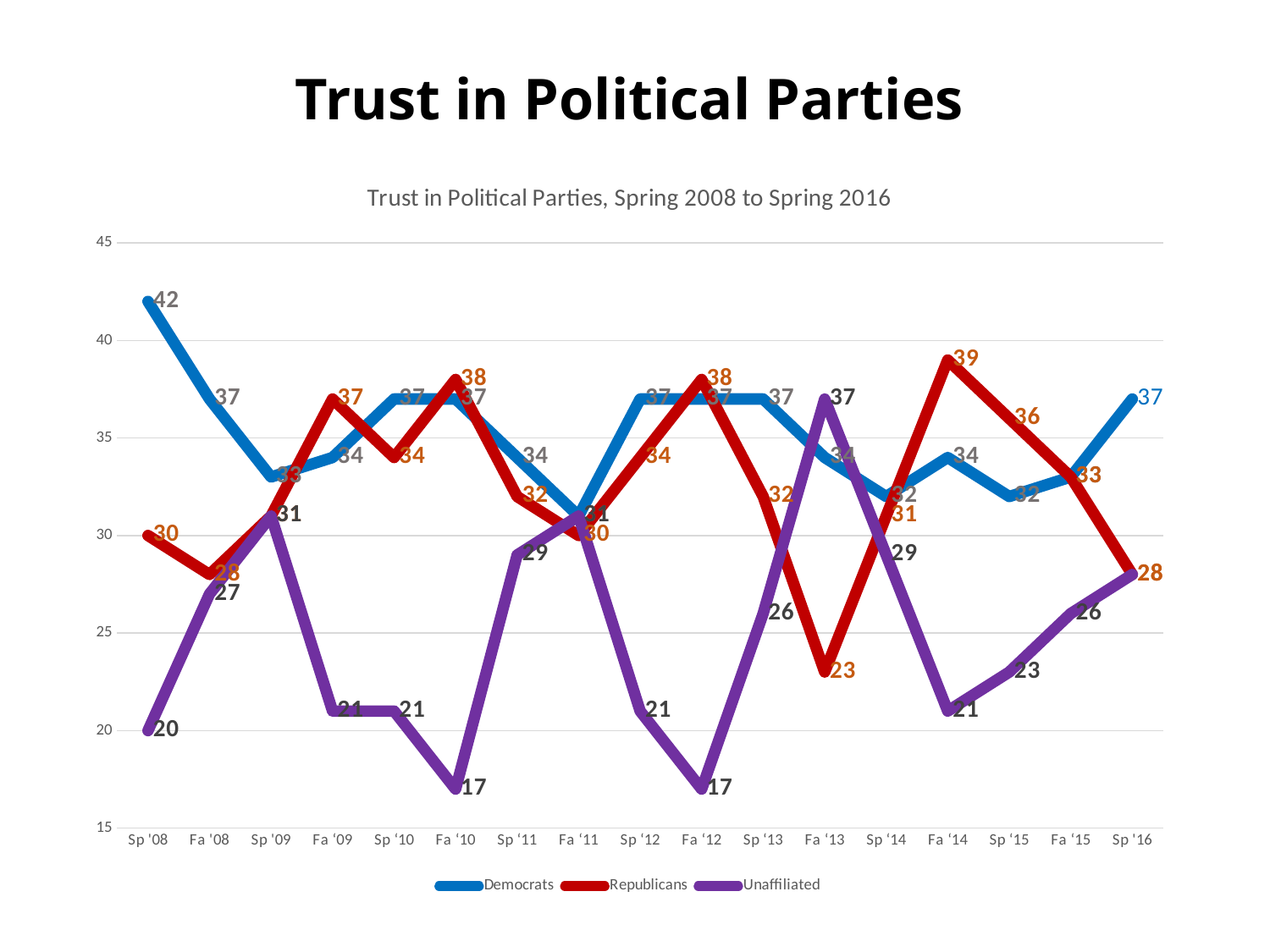
What is the difference between the Democrats and Republicans values in Sp '08? 12 What kind of chart is shown on the slide? Line chart How many series does the legend list? 3 What is the value for Unaffiliated in Sp '16? 28 What colour is the Democrats line? Blue What is the value for Democrats in Sp '08? 42 What is the value for Republicans in Fa '14? 39 How many time periods are shown on the x axis? 17 In which period does the Republicans series reach its lowest value? Fa '13 What is the value for Unaffiliated in Fa '10? 17 In which period does the Republicans series reach its highest value? Fa '14 In Fa '13, which is larger: the Republicans value or the Unaffiliated value? Unaffiliated